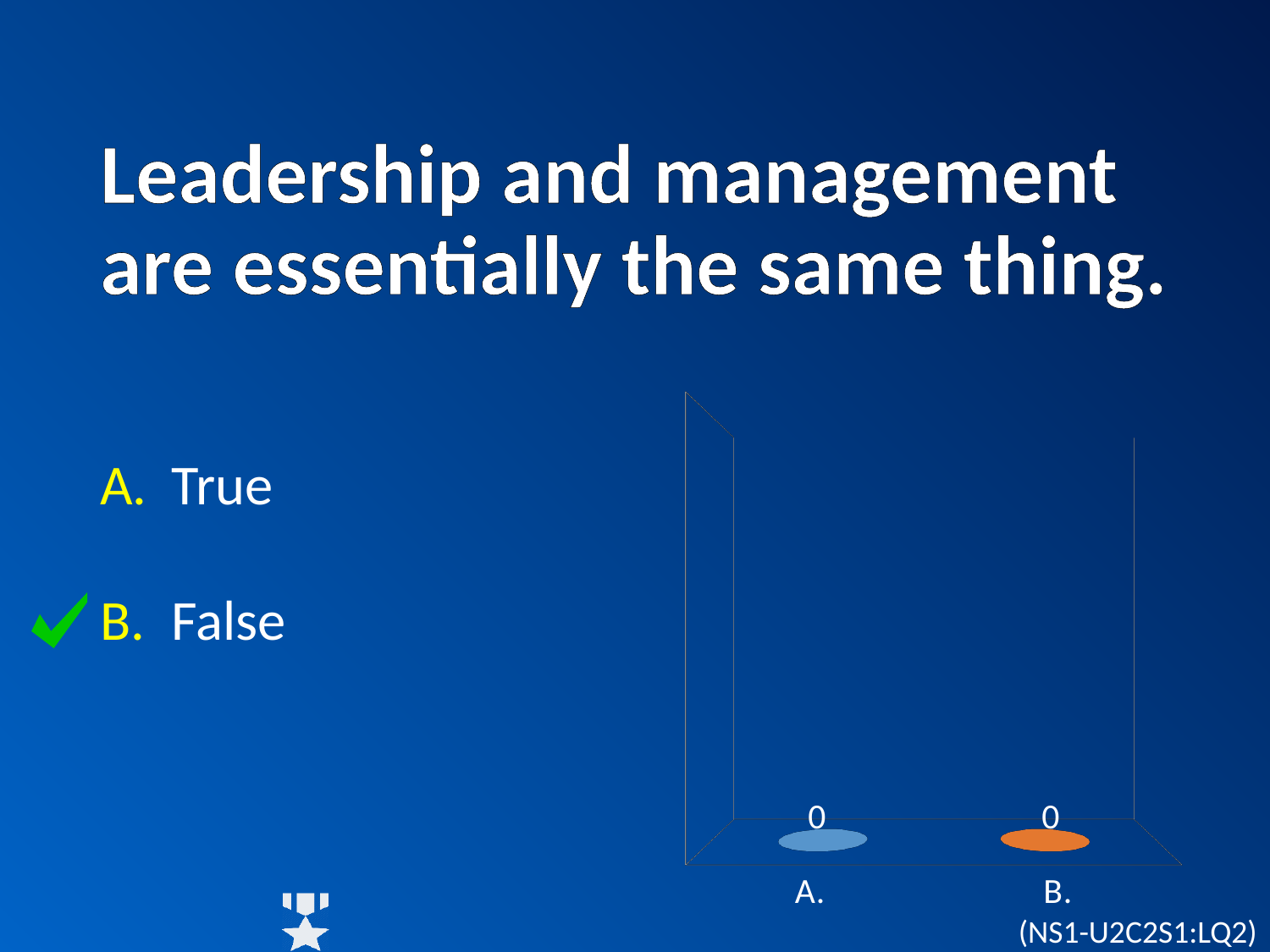
What is the value for category B. in the chart? 0 What is the value for category A. in the chart? 0 What colour is the bar for category A. in the chart? blue What kind of chart is shown on the slide? bar chart What are the category labels on the x axis of the chart? A. and B. How many categories are shown on the x axis of the chart? 2 What is the difference between the values for A. and B. in the chart? 0